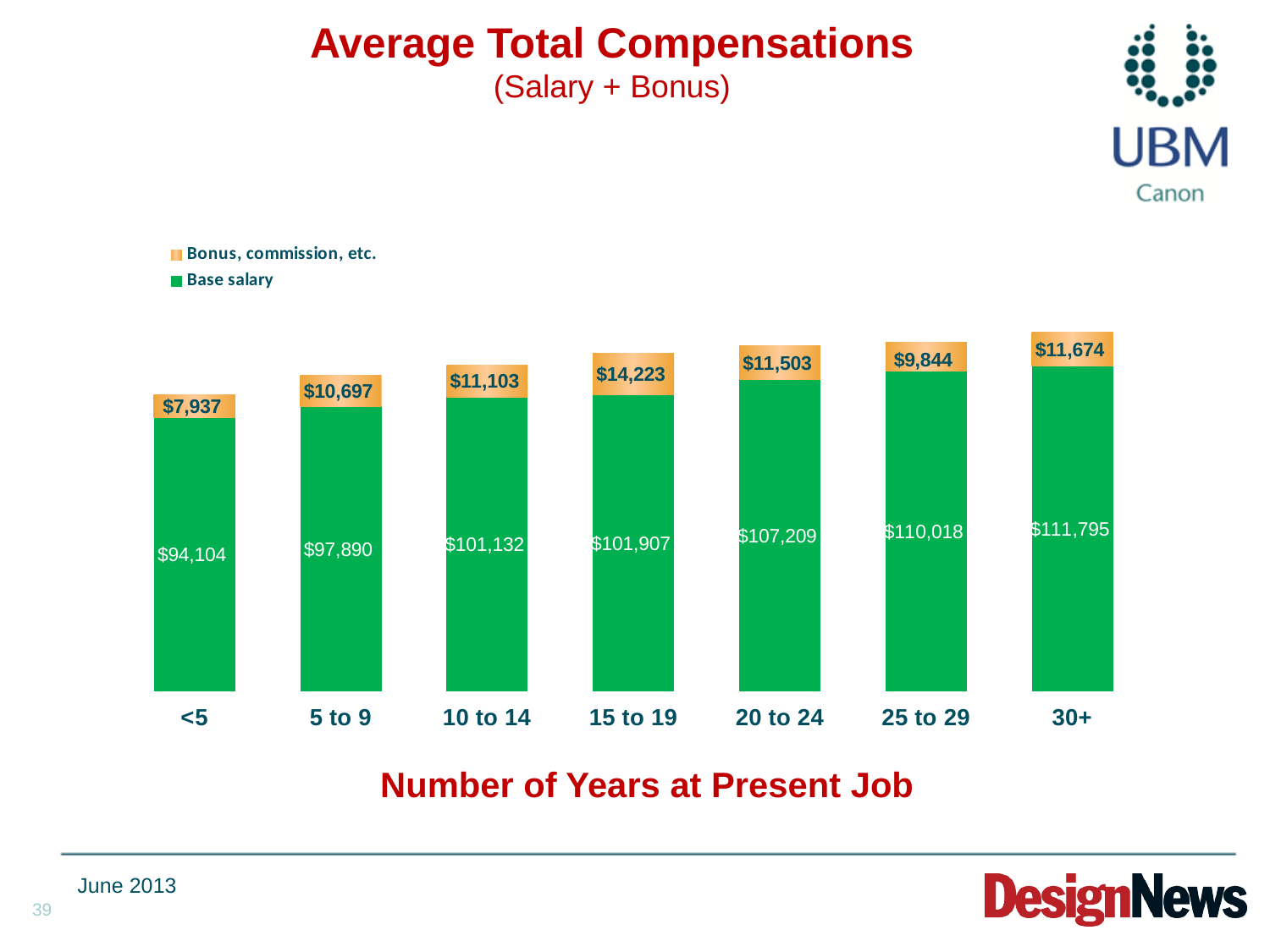
Which category has the highest bonus, commission, etc. value? 15 to 19 What is the bonus, commission, etc. value for the '15 to 19' years category? $14,223 What is the difference between the base salary for '30+' and the base salary for '<5'? $17,691 Does the base salary rise or fall as the number of years at present job increases? Rises What is the base salary for the '10 to 14' years category? $101,132 How many year-range categories are shown on the x axis? 7 How many series does the legend list? 2 Which category has the lowest base salary? <5 What kind of chart is shown on the slide? Stacked bar chart What is the total compensation (base salary plus bonus) for the '<5' years category? $102,041 What is the base salary for the '30+' years category? $111,795 Which is larger, the bonus for '20 to 24' or the bonus for '25 to 29'? 20 to 24